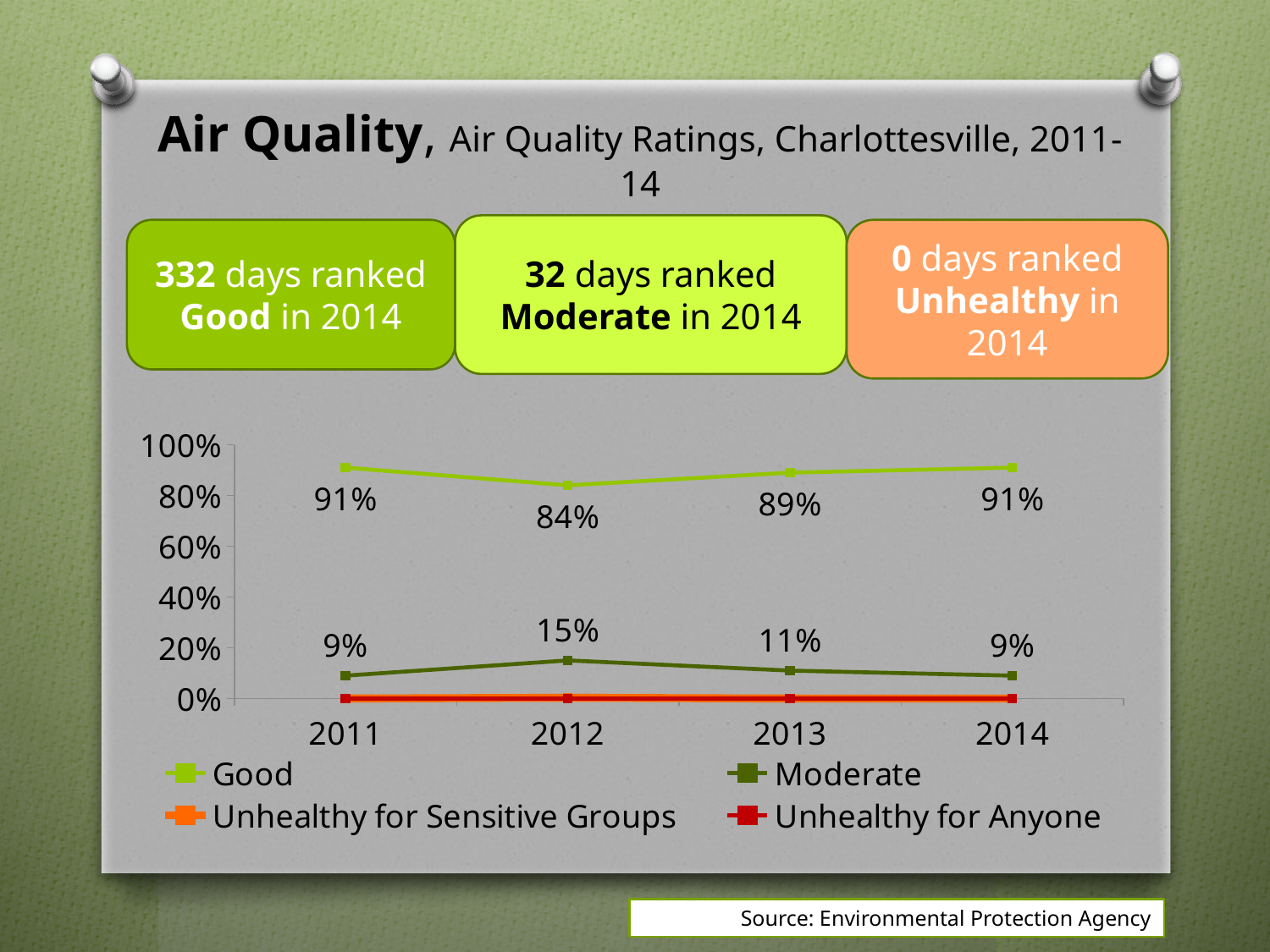
What is the difference between the Moderate share in 2012 and in 2014? 6% Is the Moderate value for 2012 greater or less than 20%? less Does the Good share rise or fall from 2012 to 2014? rise What is the difference between the Good share in 2011 and in 2012? 7% How many years are shown on the x axis? 4 What kind of chart is shown? line chart What percentage of days were ranked Good in 2012? 84% How many series does the legend list? 4 In which year was the Moderate share highest? 2012 What percentage of days were ranked Moderate in 2013? 11% Which is larger, the Good share in 2013 or the Good share in 2014? 2014 In which year was the Good share lowest? 2012